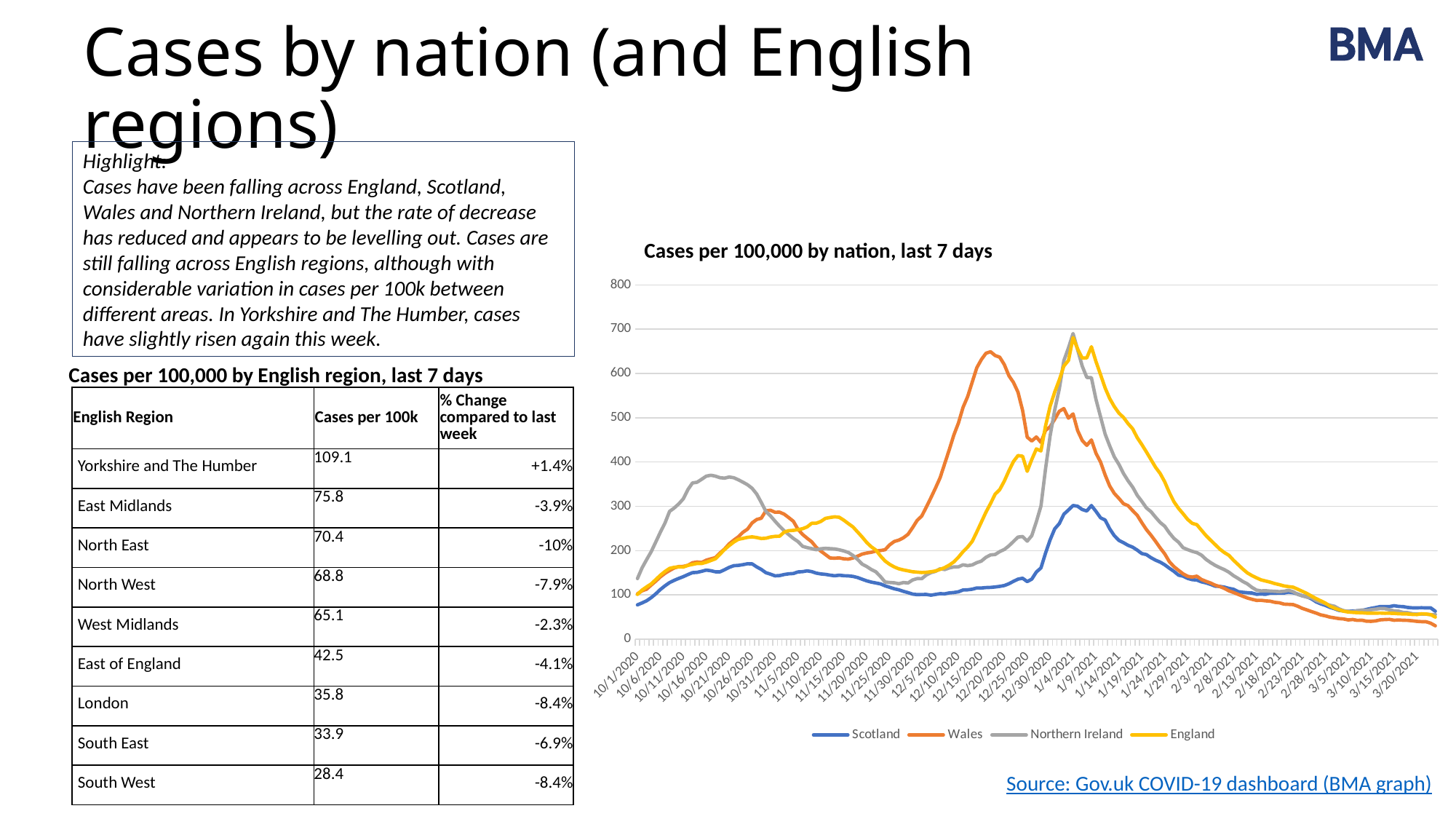
In the 'Cases per 100,000 by nation, last 7 days' chart, what colour is the Scotland line? blue In the 'Cases per 100,000 by nation, last 7 days' chart, is the value for Northern Ireland around 10/21/2020 greater or less than 300? greater In the 'Cases per 100,000 by nation, last 7 days' chart, which is larger around 12/20/2020: the value for Wales or the value for Scotland? Wales In the 'Cases per 100,000 by nation, last 7 days' chart, is the highest value reached by Scotland greater or less than 400? less In the 'Cases per 100,000 by nation, last 7 days' chart, is the peak value for Wales around 12/20/2020 greater or less than 600? greater What kind of chart is 'Cases per 100,000 by nation, last 7 days'? line chart Which nations are listed in the legend of the 'Cases per 100,000 by nation, last 7 days' chart? Scotland, Wales, Northern Ireland, England In the 'Cases per 100,000 by nation, last 7 days' chart, which is larger around 10/21/2020: the value for Northern Ireland or the value for Wales? Northern Ireland In the 'Cases per 100,000 by nation, last 7 days' chart, does the England line rise or fall between 1/9/2021 and 3/20/2021? fall How many series does the legend of the 'Cases per 100,000 by nation, last 7 days' chart list? 4 In the 'Cases per 100,000 by nation, last 7 days' chart, which nation has the lowest peak value over the period shown? Scotland